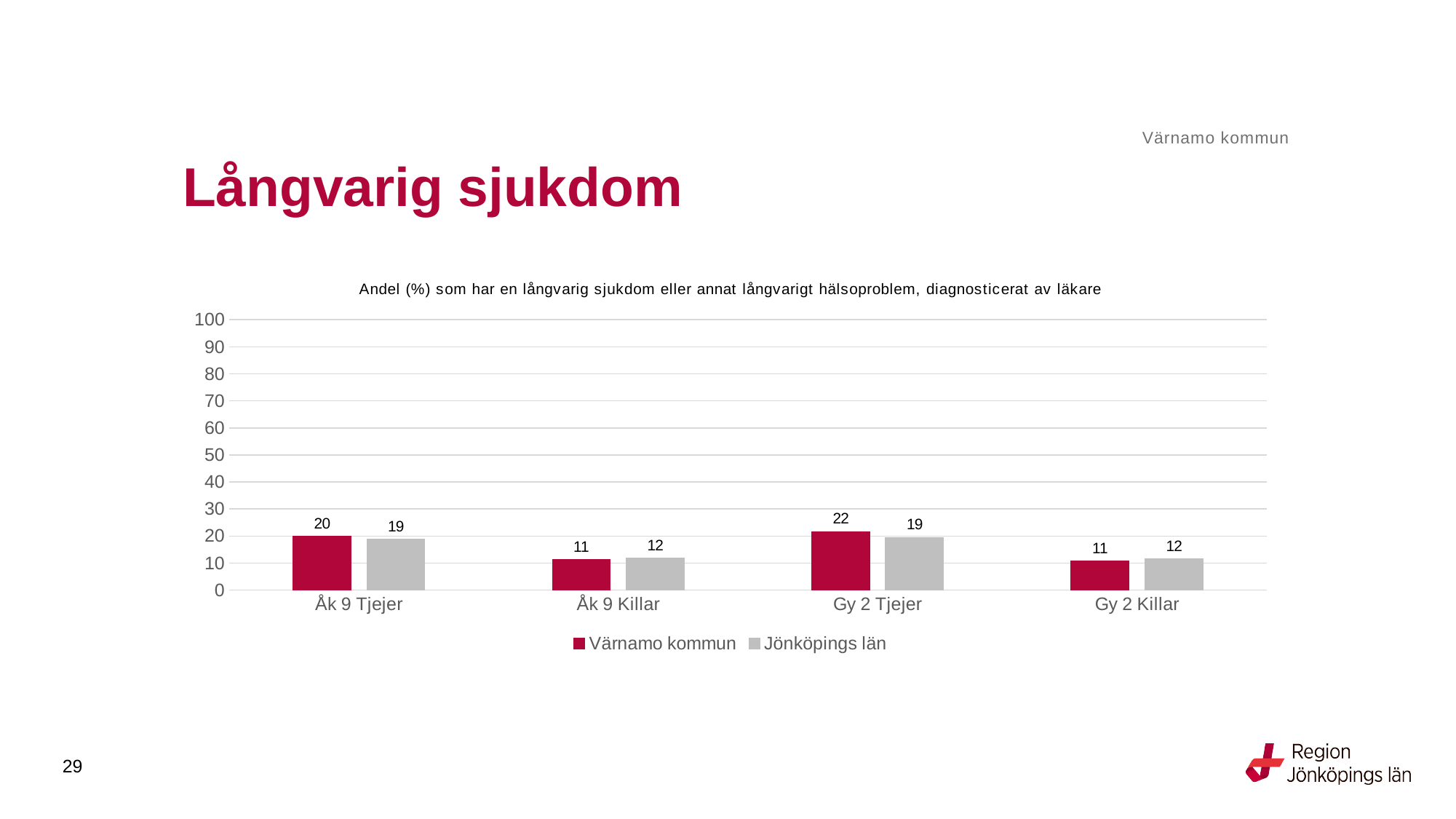
How many categories are shown on the x axis? 4 What kind of chart is shown on the slide? bar chart Which category has the highest value for Värnamo kommun? Gy 2 Tjejer Which category has the lowest value for Jönköpings län? Åk 9 Killar and Gy 2 Killar (both 12) Which series is shown in grey in the legend? Jönköpings län What is the value for Värnamo kommun for Gy 2 Killar? 11 How many series does the legend list? 2 Which is larger for Åk 9 Killar: Värnamo kommun or Jönköpings län? Jönköpings län What is the value for Jönköpings län for Gy 2 Tjejer? 19 What is the value for Värnamo kommun for Åk 9 Tjejer? 20 Is the value for Värnamo kommun for Gy 2 Tjejer greater or less than 30? less What is the difference between Värnamo kommun and Jönköpings län for Gy 2 Tjejer? 3